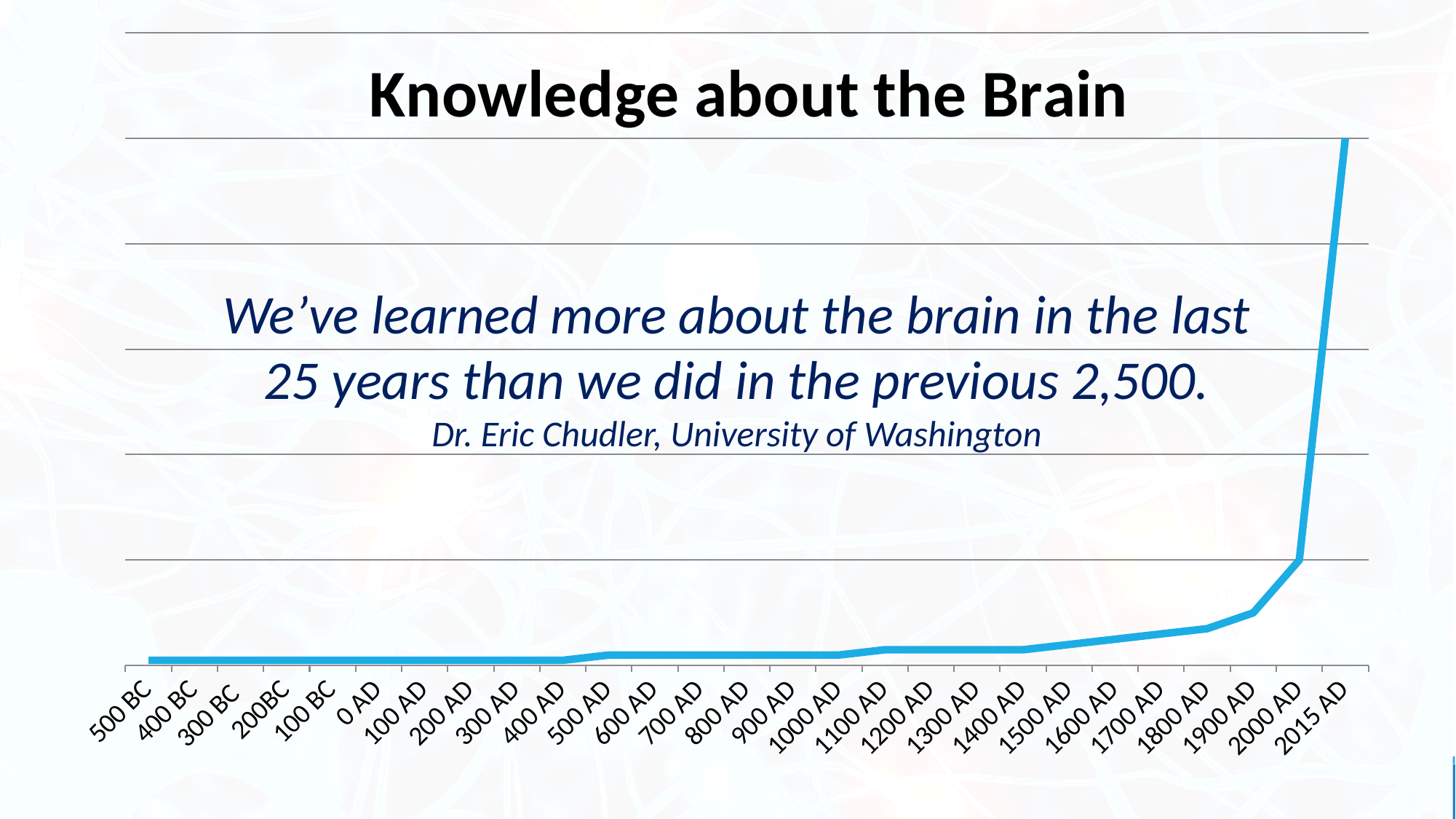
Do the values on the chart rise or fall moving from 500 BC to 2015 AD? rise Which has the larger value on the chart, 2000 AD or 1000 AD? 2000 AD What is the title of the chart on the slide? Knowledge about the Brain What is the first category on the x axis of the chart? 500 BC What kind of chart is shown on the slide? line chart Which x-axis category has the highest value on the chart? 2015 AD Which has the larger value on the chart, 2015 AD or 1900 AD? 2015 AD Which has the larger value on the chart, 2000 AD or 1800 AD? 2000 AD How many points are plotted along the x axis of the chart? 27